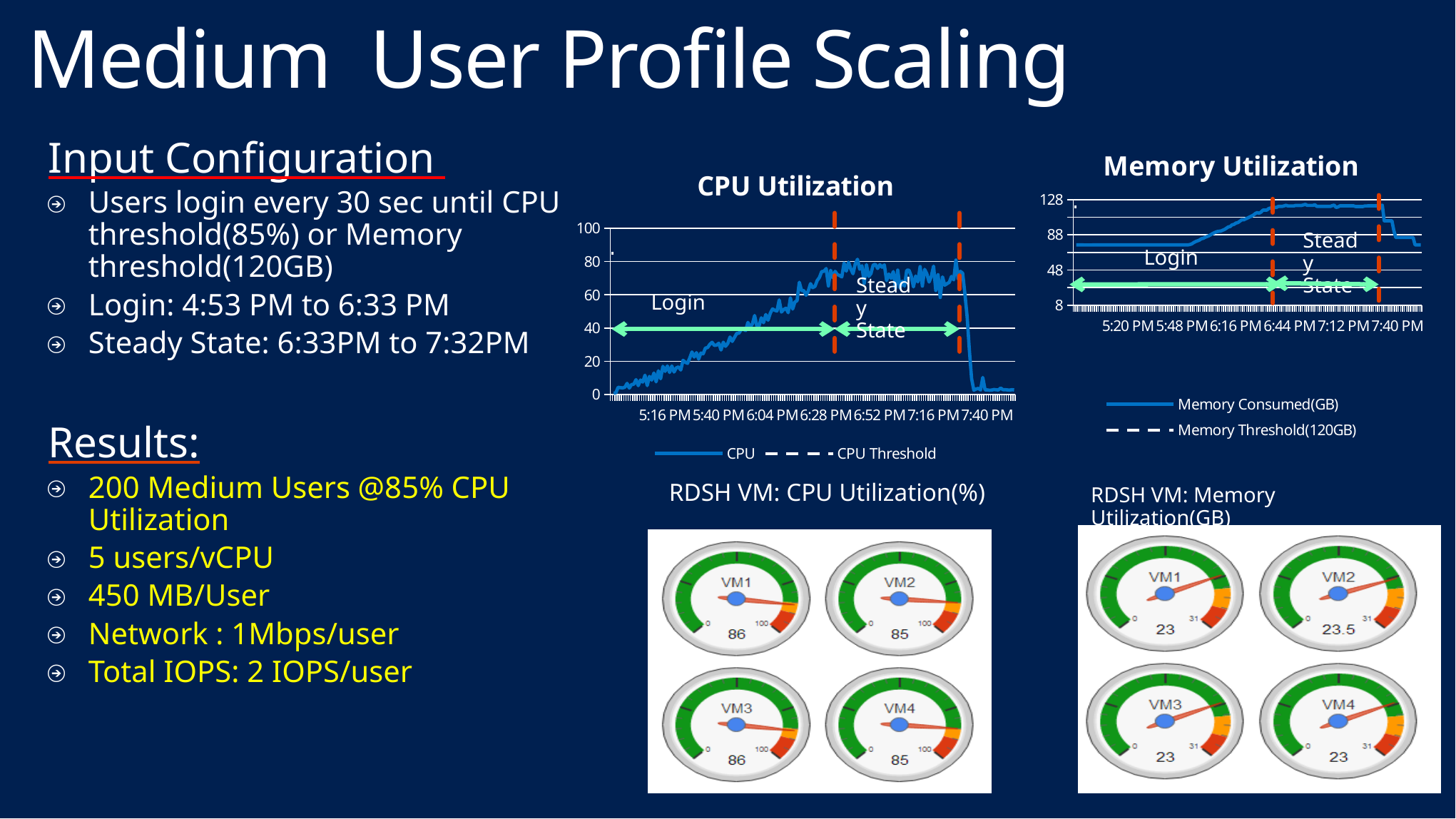
In the CPU Utilization chart, is the CPU value at 5:40 PM greater or less than 40? less How many series does the legend of the CPU Utilization chart list? 2 In the Memory Utilization chart, is the Memory Consumed value at 5:48 PM greater or less than 88? less How many series does the legend of the Memory Utilization chart list? 2 In the RDSH VM: CPU Utilization(%) gauges, what is the value shown for VM1? 86 In the RDSH VM: Memory Utilization(GB) gauges, what is the difference between the VM2 value and the VM1 value? 0.5 In the Memory Utilization chart, is the Memory Consumed value at 7:12 PM greater or less than 88? greater How many gauges are shown in the RDSH VM: CPU Utilization(%) panel? 4 What kind of chart is the CPU Utilization chart? line chart In the RDSH VM: Memory Utilization(GB) gauges, which VM shows the highest value? VM2 In the CPU Utilization chart, does the CPU value rise or fall between 5:16 PM and 6:28 PM? rise